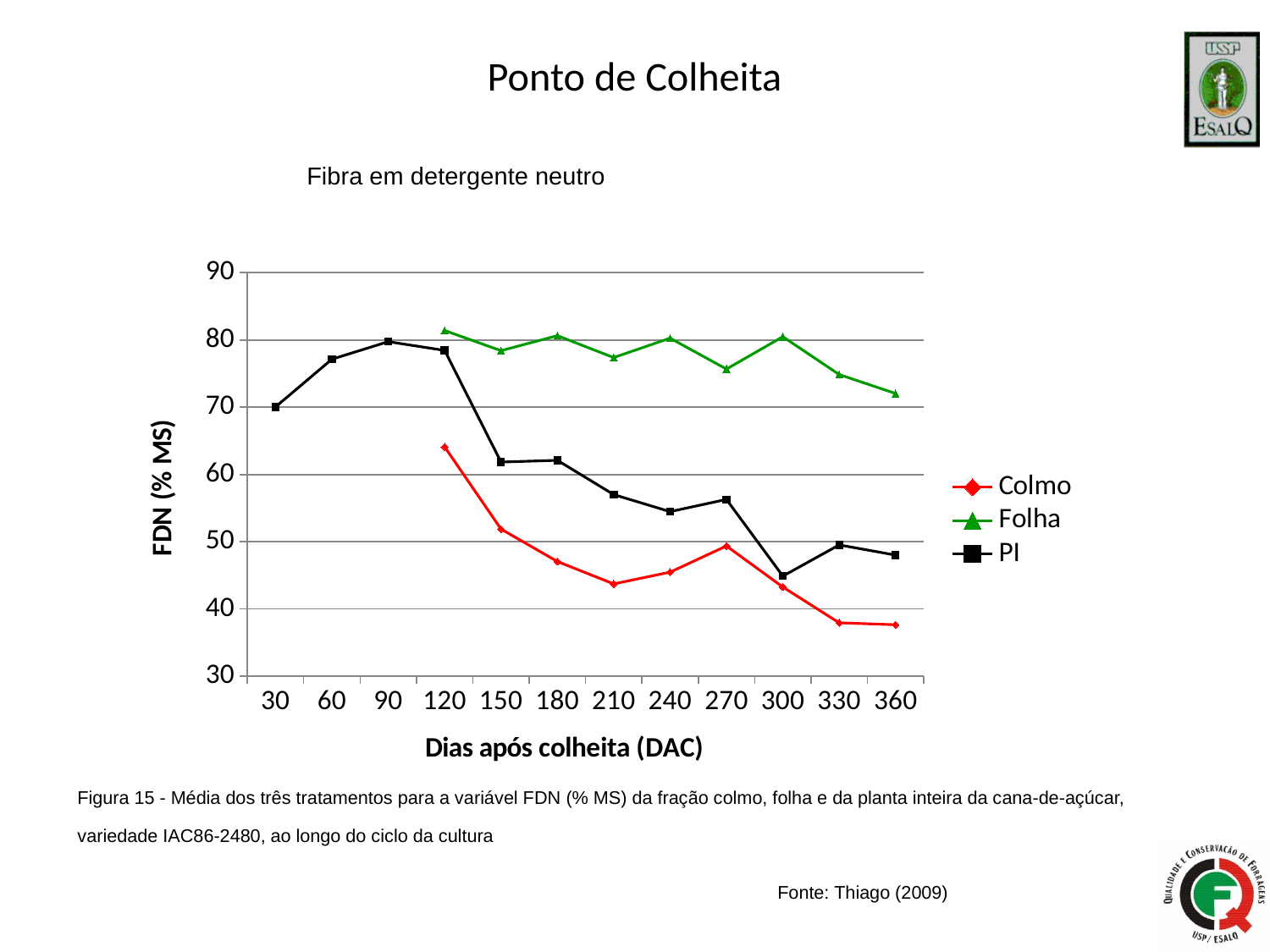
How many series does the legend list? 3 What is the title of the y axis? FDN (% MS) What is the FDN value for PI at 30 DAC? 70 Is the value for PI at 300 DAC greater or less than 50? less Does the Colmo series generally rise or fall from 120 DAC to 360 DAC? fall Is the value for Colmo at 120 DAC greater or less than 60? greater Is the value for Colmo at 360 DAC greater or less than 40? less Which series has the highest value at 360 DAC? Folha What kind of chart is shown on the slide? line chart At 270 DAC, which is larger, PI or Colmo? PI How many points are labelled on the x axis (Dias após colheita)? 12